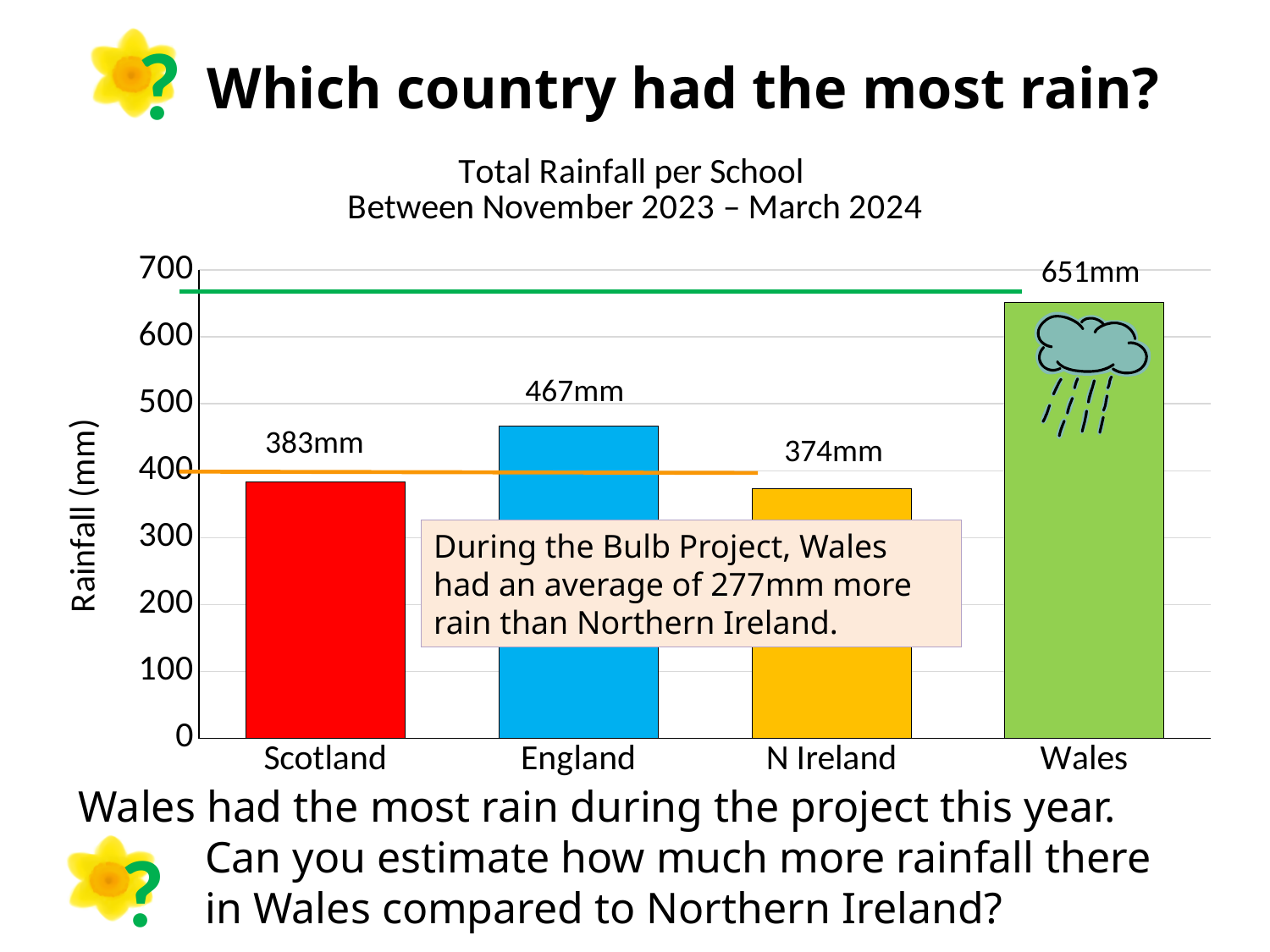
What is the difference in rainfall between England and Scotland? 84mm What kind of chart is shown on the slide? Bar chart Which country has the lowest rainfall in the chart? N Ireland What is the rainfall value for N Ireland? 374mm Which has more rainfall, England or Wales? Wales What is the rainfall value for Wales? 651mm What is the label on the vertical axis of the chart? Rainfall (mm) Which country has the highest rainfall in the chart? Wales What is the rainfall value for England? 467mm What is the rainfall value for Scotland? 383mm How many countries are shown in the chart? 4 What is the difference in rainfall between Wales and N Ireland? 277mm